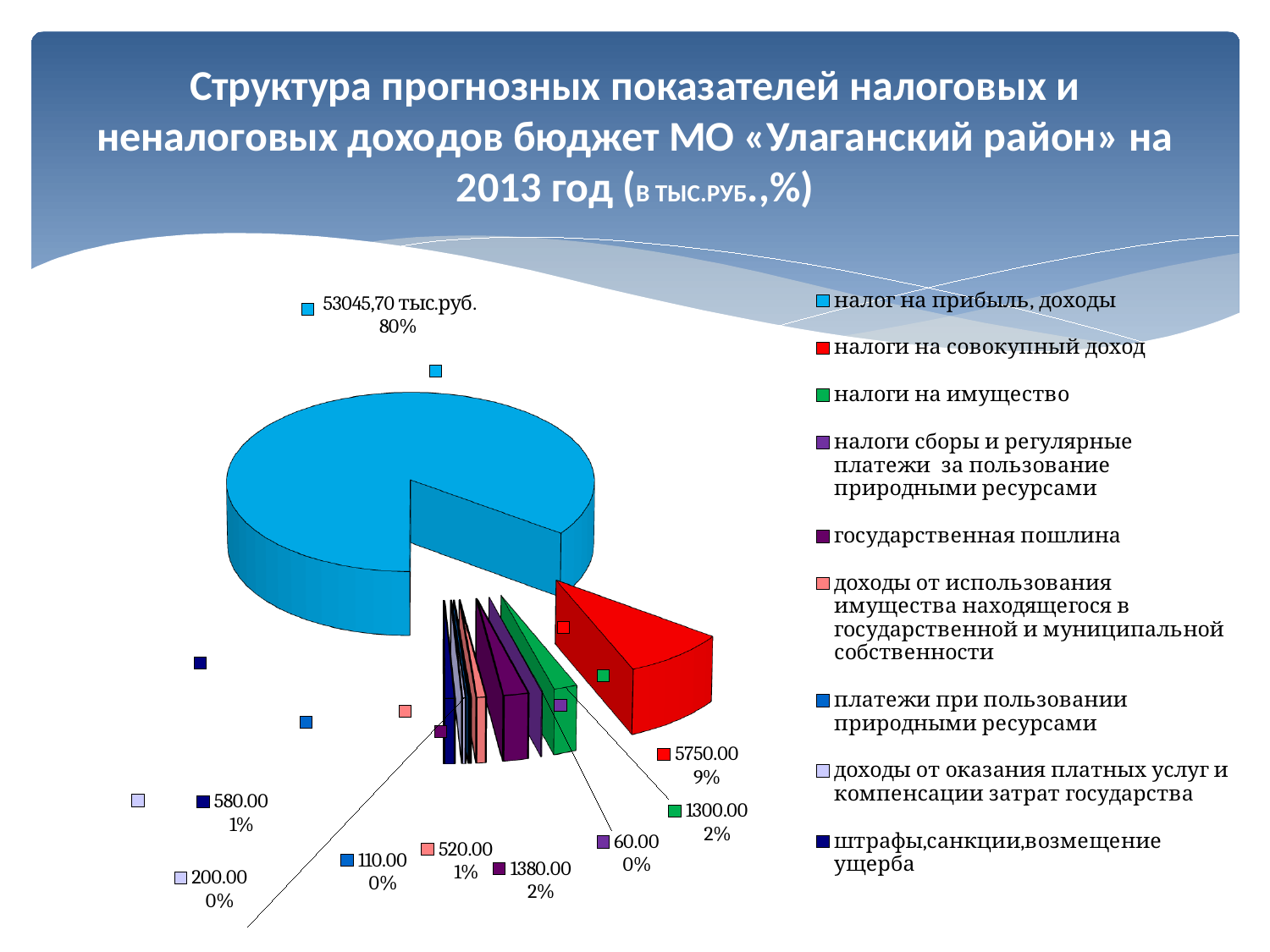
What value is shown for "штрафы,санкции,возмещение ущерба"? 580.00 Which is larger: the value for "доходы от использования имущества находящегося в государственной и муниципальной собственности" or the value for "платежи при пользовании природными ресурсами"? доходы от использования имущества находящегося в государственной и муниципальной собственности What kind of chart is shown on the slide? pie chart What value is shown for "государственная пошлина"? 1380.00 What share of the pie does "налог на прибыль, доходы" represent? 80% What share of the pie does "налоги на совокупный доход" represent? 9% What is the difference between the values for "налоги на совокупный доход" and "налоги на имущество"? 4450.00 What value is shown for "налог на прибыль, доходы"? 53045,70 тыс.руб. What value is shown for "налоги на совокупный доход"? 5750.00 Which category has the largest slice of the pie? налог на прибыль, доходы How many categories does the legend of the pie chart list? 9 Which category has the smallest value in the pie chart? налоги сборы и регулярные платежи за пользование природными ресурсами